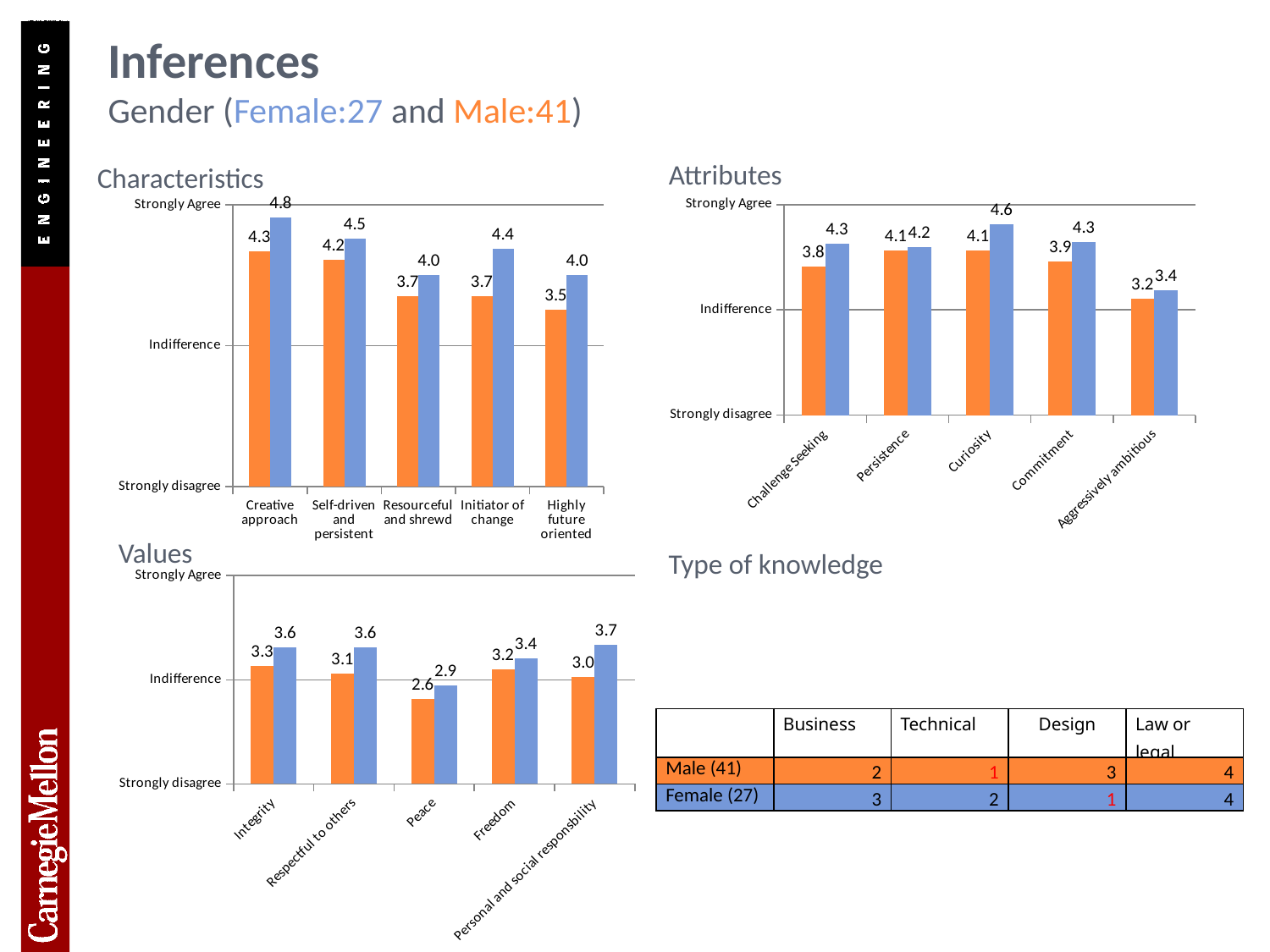
In the Characteristics chart, what is the value of the orange (Male) bar for Highly future oriented? 3.5 In the Values chart, which is larger for Personal and social responsibility, the orange bar or the blue bar? the blue bar In the Characteristics chart, what is the difference between the blue and orange bars for Initiator of change? 0.7 In the Values chart, is the orange (Male) bar for Peace above or below the Indifference line? below In the Characteristics chart, which category has the highest blue (Female) bar? Creative approach In the Attributes chart, how many categories are shown on the x axis? 5 In the Values chart, what is the difference between the blue and orange bars for Respectful to others? 0.5 In the Characteristics chart, what is the value of the blue (Female) bar for Creative approach? 4.8 In the Values chart, what is the value of the orange (Male) bar for Peace? 2.6 In the Attributes chart, what is the value of the blue (Female) bar for Curiosity? 4.6 What type of chart is the Values chart? bar chart In the Attributes chart, which category has the lowest orange (Male) bar? Aggressively ambitious